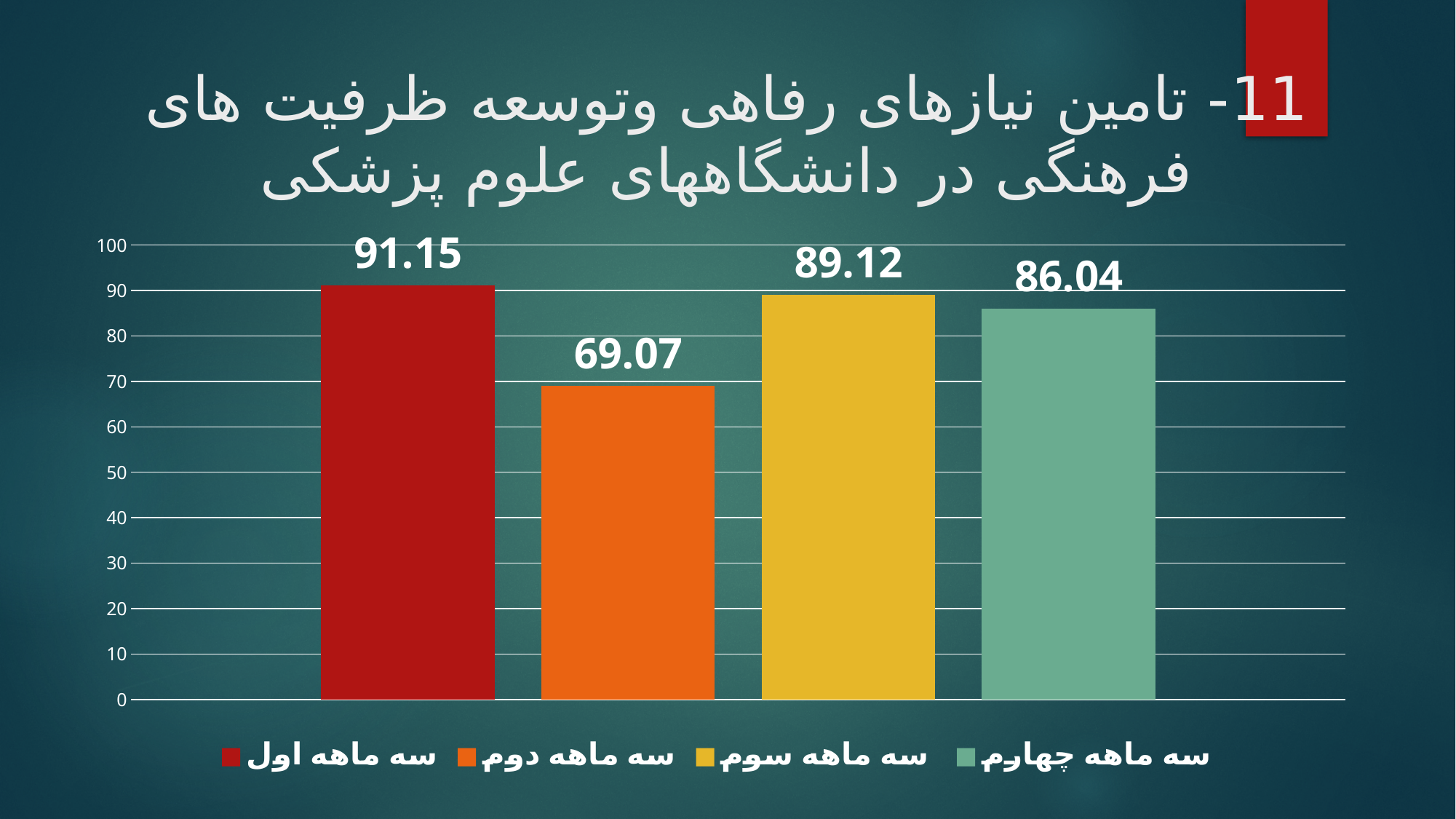
Which quarter has the highest value? سه ماهه اول What is the value for سه ماهه دوم (second quarter)? 69.07 What is the value for سه ماهه چهارم (fourth quarter)? 86.04 What is the value for سه ماهه سوم (third quarter)? 89.12 How many bars are plotted in the chart? 4 What is the difference between the values for سه ماهه اول and سه ماهه دوم? 22.08 Which quarter has the lowest value? سه ماهه دوم What colour is the bar for سه ماهه دوم? Orange What kind of chart is shown on the slide? Bar chart Which is larger, the value for سه ماهه سوم or سه ماهه چهارم? سه ماهه سوم What is the value for سه ماهه اول (first quarter)? 91.15 How many entries does the legend list? 4